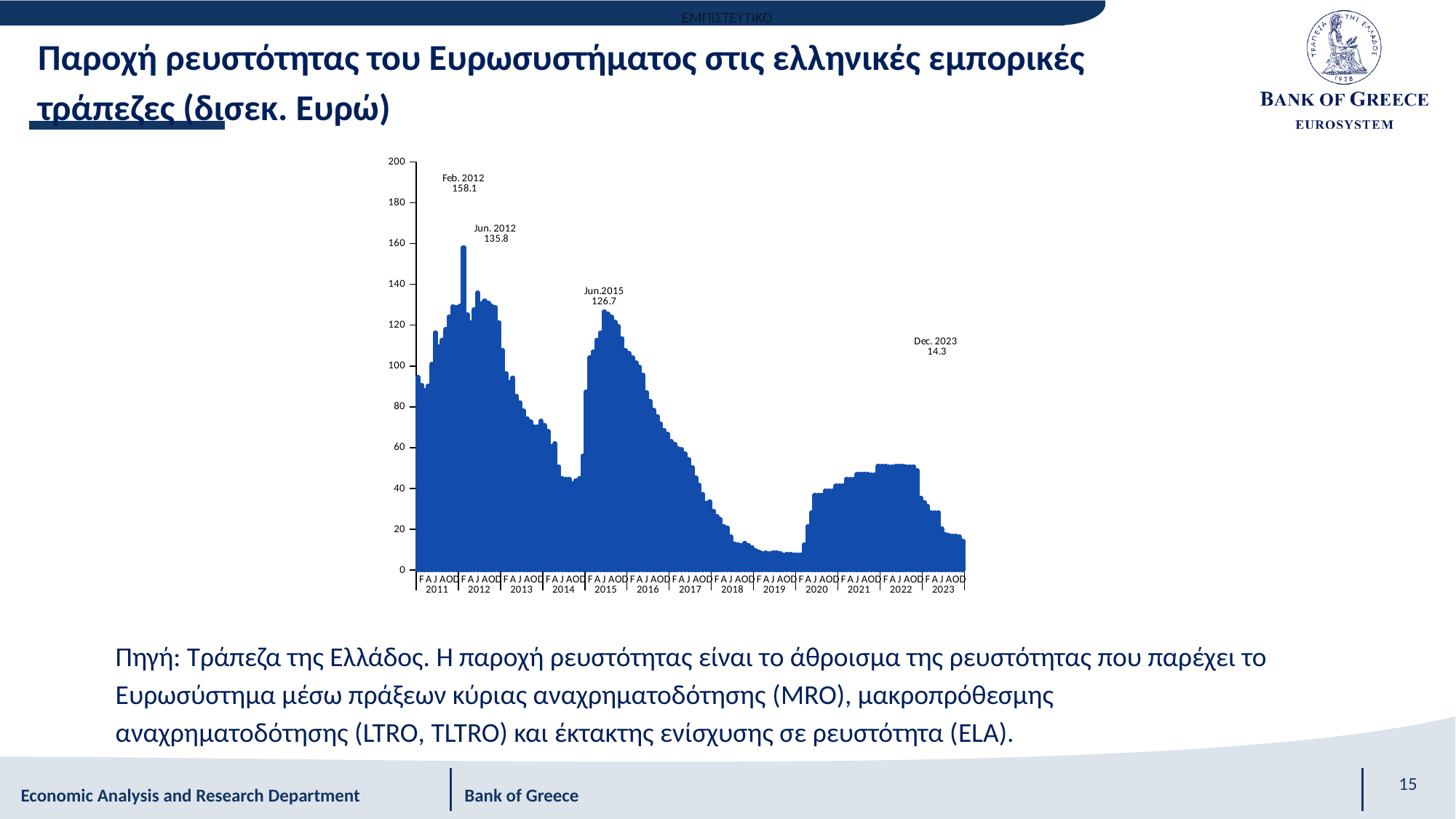
What value is labelled for Feb. 2012 on the chart? 158.1 Are the values during 2019 greater or less than 20? less What kind of chart is shown on the slide? bar chart Which labelled point on the chart has the lowest value? Dec. 2023 What value is labelled for Jun. 2012 on the chart? 135.8 Which is larger, the labelled value for Jun. 2012 or for Jun. 2015? Jun. 2012 What is the difference between the labelled values for Jun. 2012 and Jun. 2015? 9.1 Do the values rise or fall from Jun. 2015 to the end of 2018? fall What is the difference between the labelled values for Feb. 2012 and Dec. 2023? 143.8 What value is labelled for Dec. 2023 on the chart? 14.3 Which labelled point on the chart has the highest value? Feb. 2012 What value is labelled for Jun. 2015 on the chart? 126.7